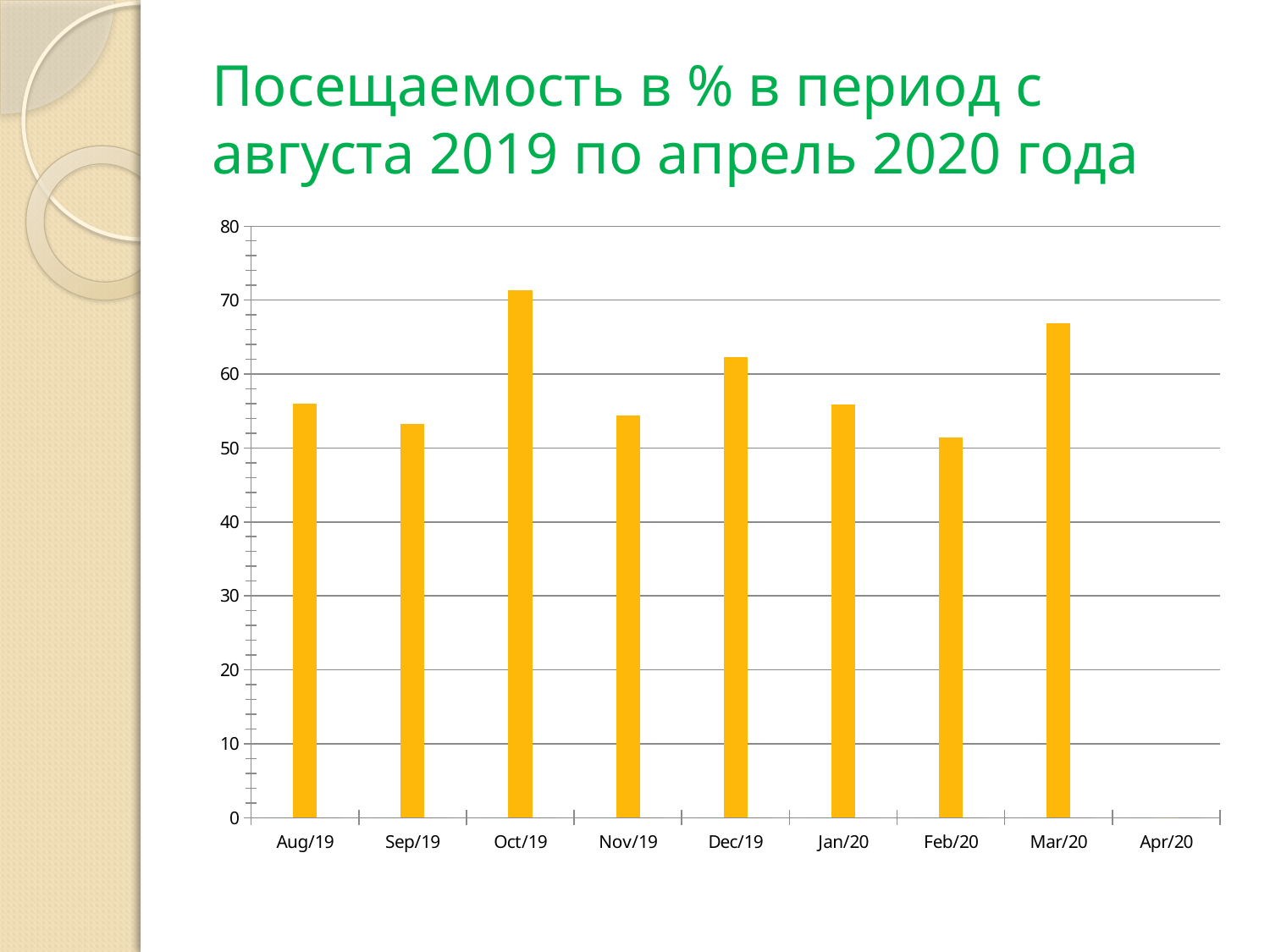
Which month has the highest bar in the chart? Oct/19 Is the value for Mar/20 greater or less than 60? greater Which month on the x axis has no bar plotted? Apr/20 Which is higher, the bar for Oct/19 or the bar for Mar/20? Oct/19 How many months are labelled on the x axis of the chart? 9 Which is higher, the bar for Dec/19 or the bar for Jan/20? Dec/19 Is the value for Sep/19 greater or less than 50? greater What kind of chart is shown on the slide? bar chart Is the value for Feb/20 greater or less than 60? less What is the highest value shown on the y axis of the chart? 80